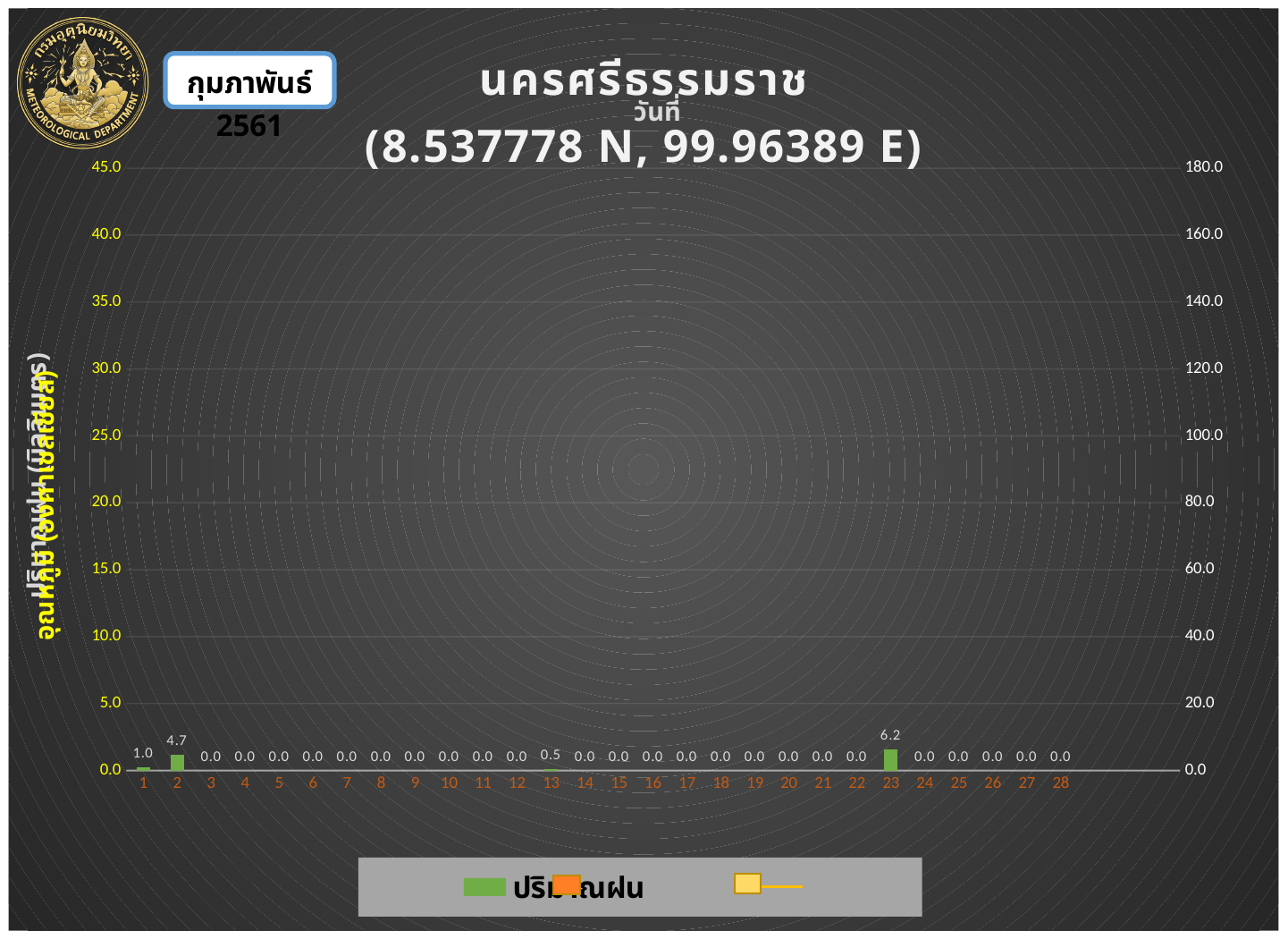
Which has a larger rainfall value, day 2 or day 13? day 2 What is the rainfall value shown for day 13? 0.5 What is the rainfall value shown for day 2? 4.7 What is the difference between the rainfall values for day 23 and day 2? 1.5 What is the rainfall value shown for day 1? 1.0 Is the rainfall value for day 23 greater or less than 5.0? greater What is the difference between the rainfall values for day 2 and day 1? 3.7 What is the highest value shown on the right-hand vertical axis? 180.0 How many days are shown on the x axis? 28 Which day has the highest rainfall value? 23 What is the rainfall value shown for day 23? 6.2 What kind of chart is used to show the rainfall values? bar chart